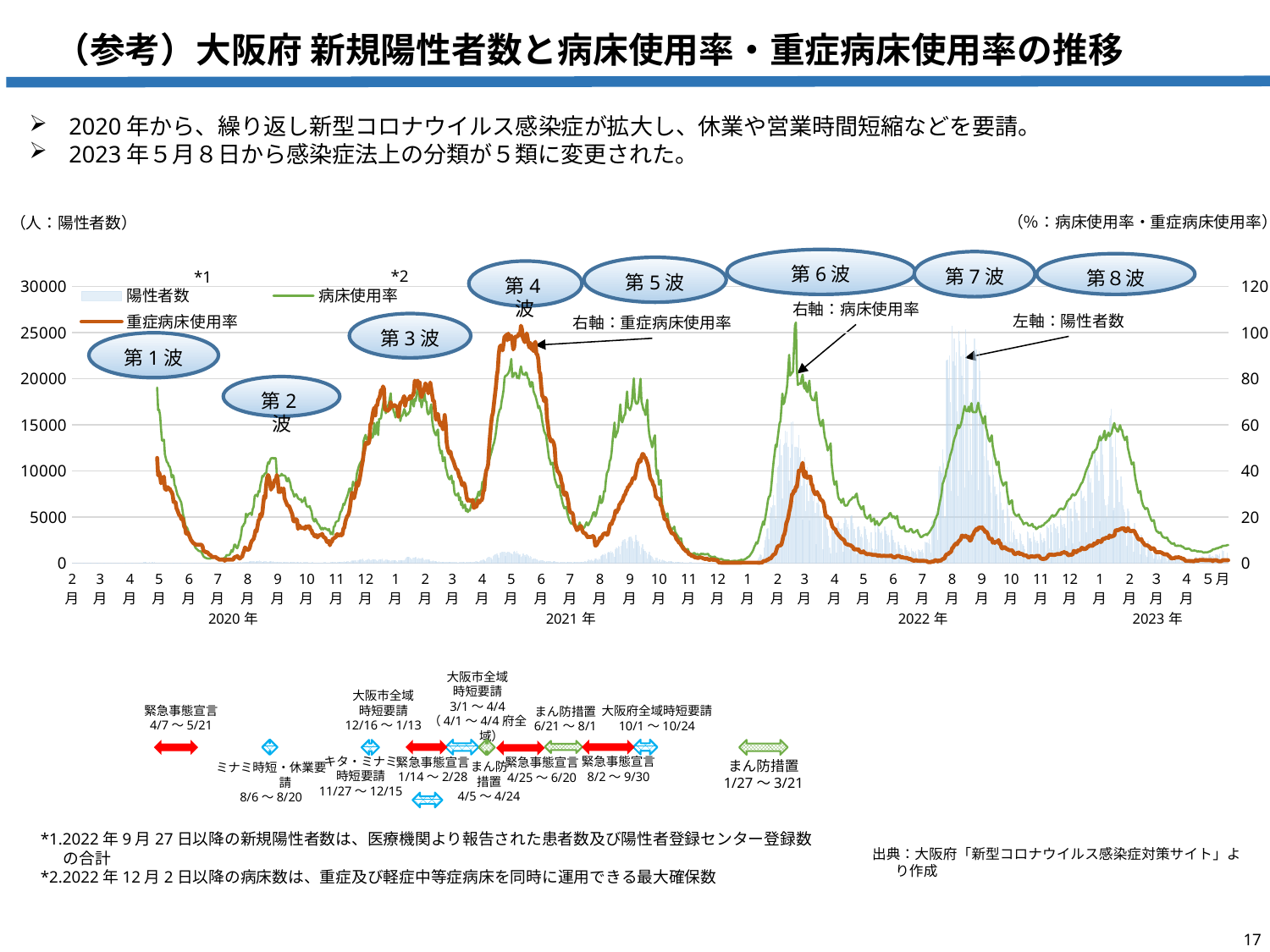
Is the peak value of 病床使用率 during 第6波 greater or less than 80? greater In which wave does 陽性者数 reach its highest peak? 第7波 How many waves (第1波 to 第8波) are labelled on the chart? 8 Is the peak value of 重症病床使用率 during 第4波 greater or less than 80? greater How many series does the chart legend list? 3 Which series is plotted on the left axis (左軸)? 陽性者数 Is the peak value of 重症病床使用率 during 第7波 greater or less than 20? less Which is larger: the peak of 重症病床使用率 in 第4波 or in 第6波? 第4波 What is the highest tick value shown on the right axis of the chart? 120 What kind of chart is shown on the slide? A combination chart with a bar series (陽性者数) and two line series